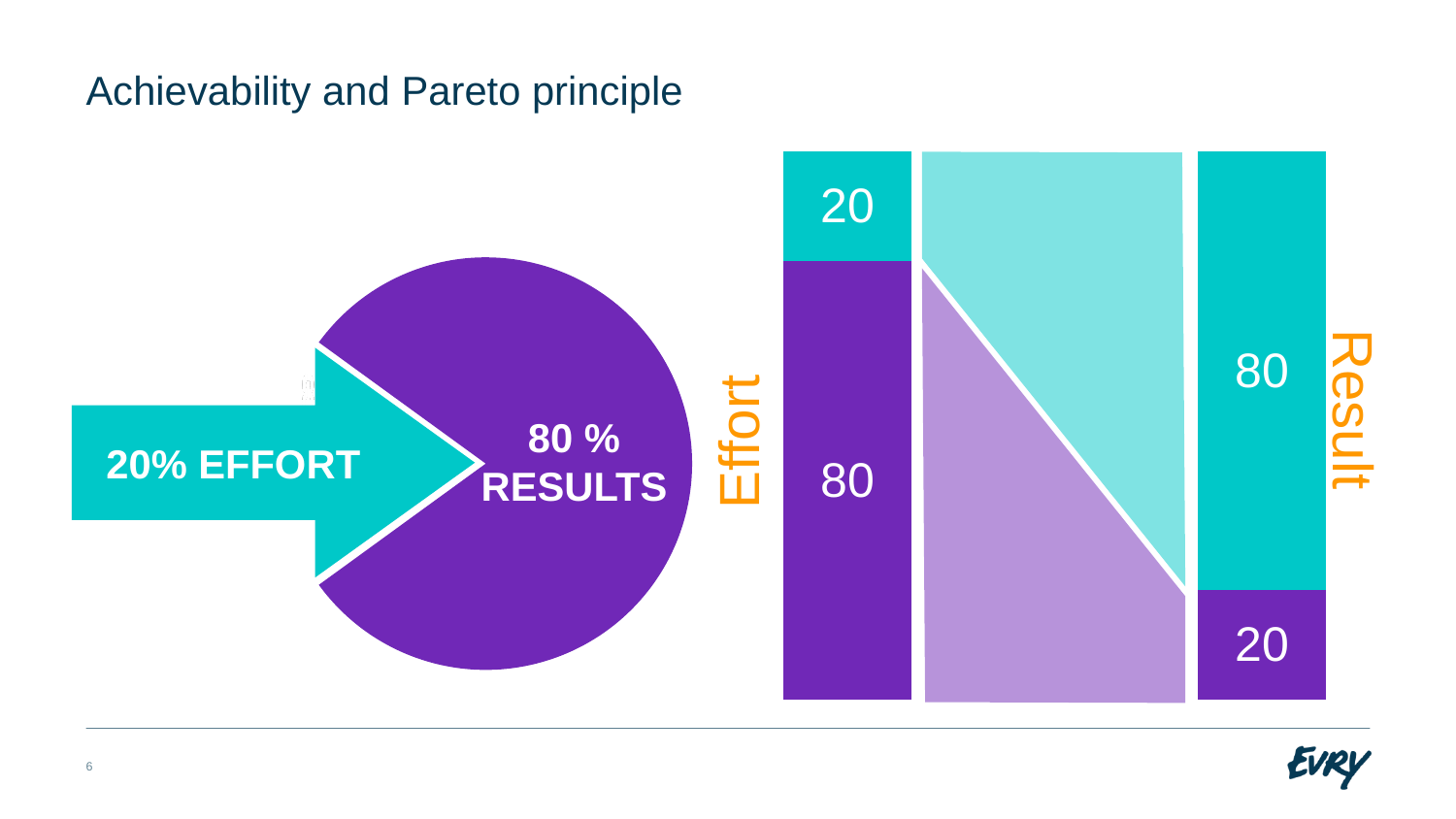
In the stacked bar chart on the right, what is the value of the purple segment in the Result bar? 20 What kind of chart is shown on the left side of the slide, next to the arrow? Pie chart In the stacked bar chart on the right, what is the value of the teal segment in the Effort bar? 20 What kind of chart is shown on the right side of the slide? Stacked bar chart In the pie chart on the left, what share is labelled on the purple slice? 80 % In the stacked bar chart on the right, what is the total of the Result bar? 100 In the stacked bar chart on the right, what is the value of the teal segment in the Result bar? 80 How many bars are shown in the stacked bar chart on the right? 2 In the stacked bar chart on the right, what is the difference between the teal segment of the Result bar and the teal segment of the Effort bar? 60 In the stacked bar chart on the right, what is the value of the purple segment in the Effort bar? 80 In the stacked bar chart on the right, what is the total of the Effort bar? 100 In the stacked bar chart on the right, which bar has the larger purple segment, Effort or Result? Effort